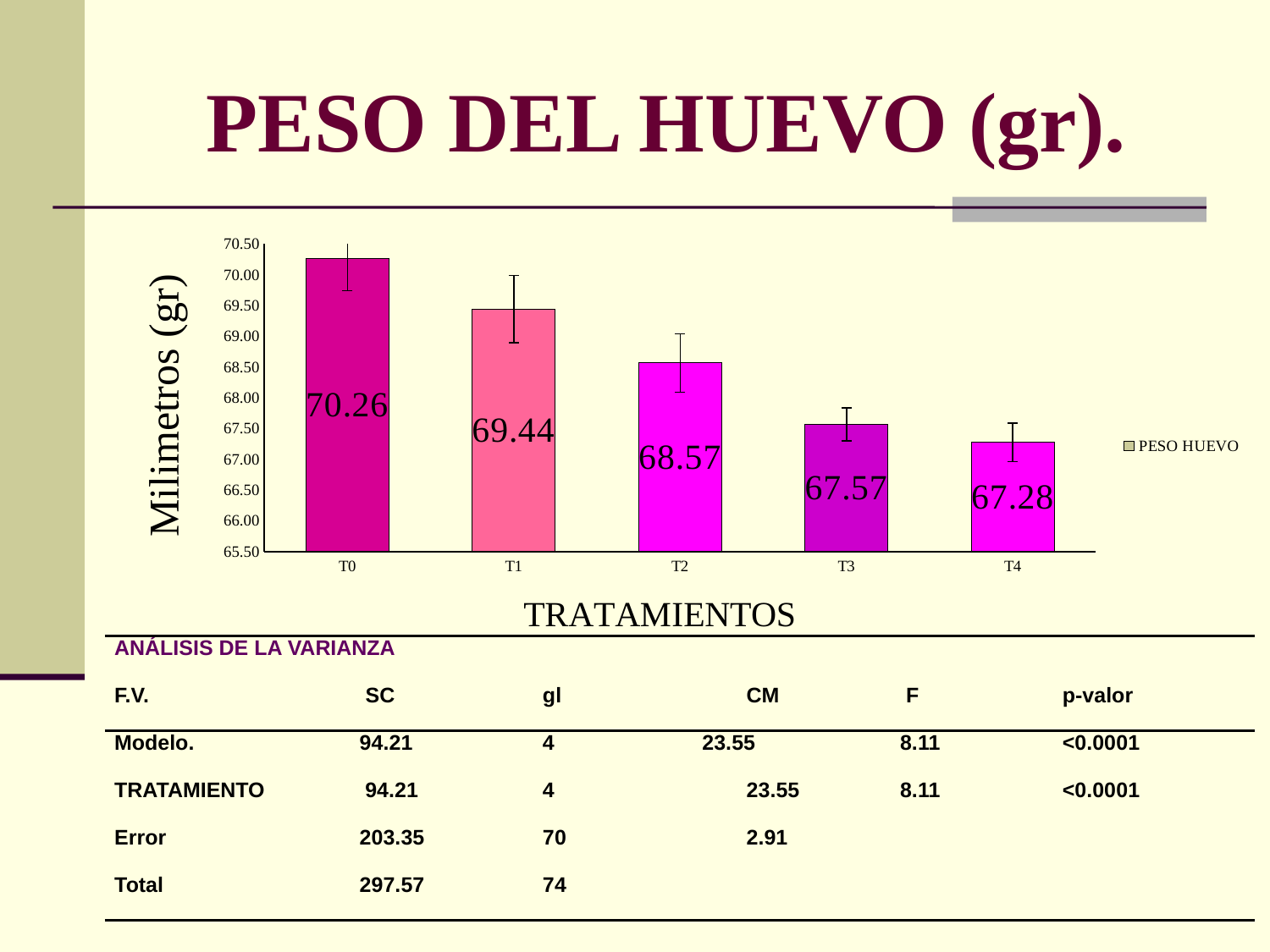
How many treatments are shown on the x axis? 5 Which treatment has the lowest value? T4 What kind of chart is shown? bar chart Which treatment has the highest value? T0 Is the value for T2 greater or less than 68.00? greater What is the value for T4? 67.28 What is the difference between the values for T1 and T2? 0.87 Do the values rise or fall from T0 to T4? fall What is the value for T3? 67.57 What is the difference between the values for T0 and T4? 2.98 What is the value for T0? 70.26 Which is larger, the value for T1 or the value for T3? T1